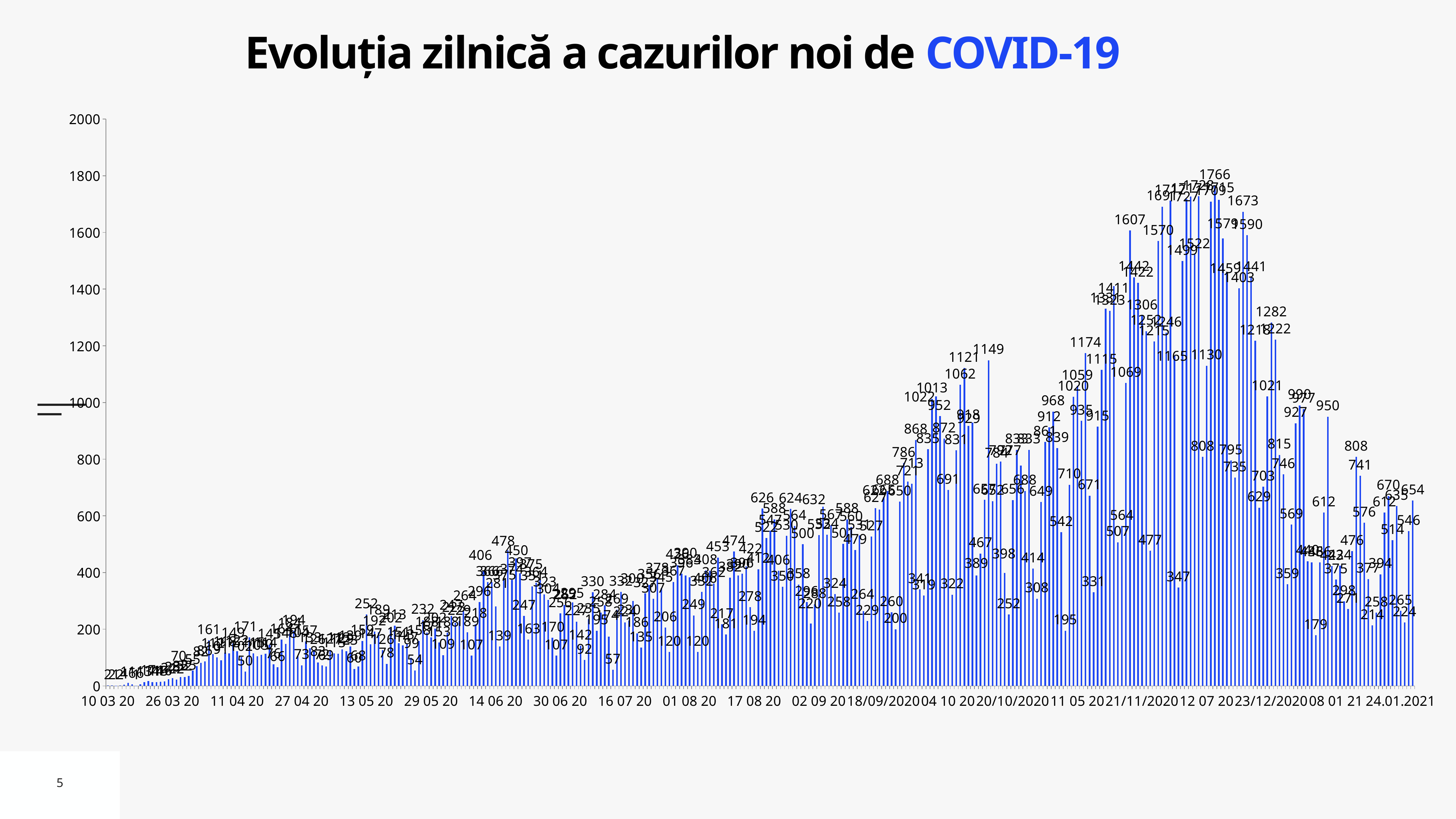
What is the highest value shown on the y axis? 2000 What is the title of the chart? Evoluția zilnică a cazurilor noi de COVID-19 Is the highest value on the chart greater or less than 1600? greater Which is larger: the peak labelled 1766 or the peak labelled 1149? 1766 What is the highest daily value labelled on the chart? 1766 Is the value for 10 03 20 greater or less than 200? less Which is larger: the June 2020 peak labelled 478 or the December 2020 peak labelled 1766? 1766 Is the value labelled 1607 greater or less than 1400? greater What kind of chart is shown on the slide? bar chart Do the values generally rise or fall from 10 03 20 to 14 06 20? rise What is the difference between the peak value 1766 and the value labelled 1673? 93